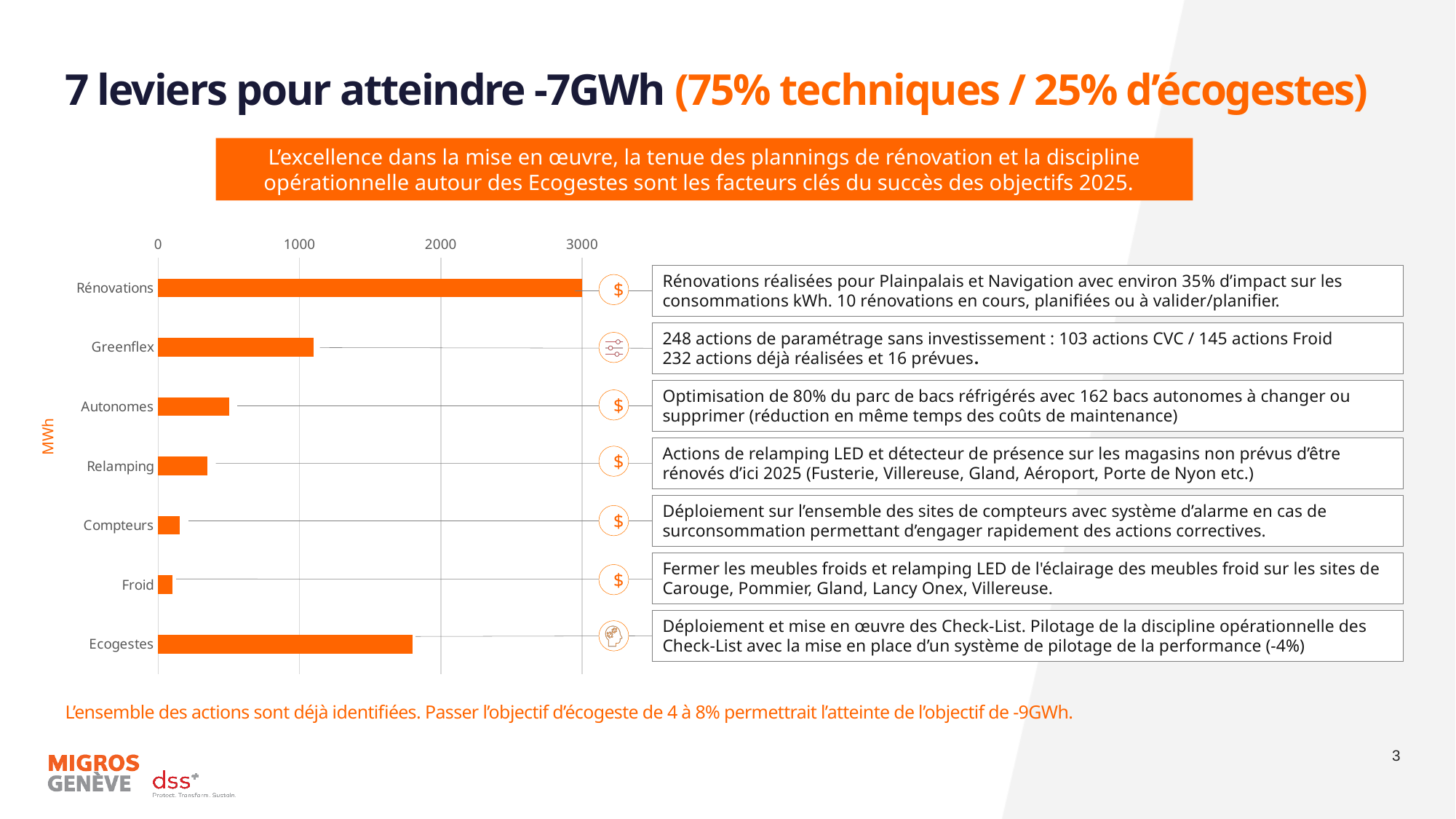
Which is larger, the value for Autonomes or the value for Relamping? Autonomes What is the highest tick value shown on the horizontal axis of the chart? 3000 Is the value for Compteurs greater or less than 1000? less Which category has the lowest value in the bar chart? Froid Which is larger, the value for Greenflex or the value for Ecogestes? Ecogestes Is the value for Rénovations greater or less than 2000? greater Which category has the highest value in the bar chart? Rénovations How many categories are plotted in the bar chart? 7 Is the value for Greenflex greater or less than 1000? greater What kind of chart is shown on the slide? bar chart What unit is shown on the vertical axis label of the chart? MWh